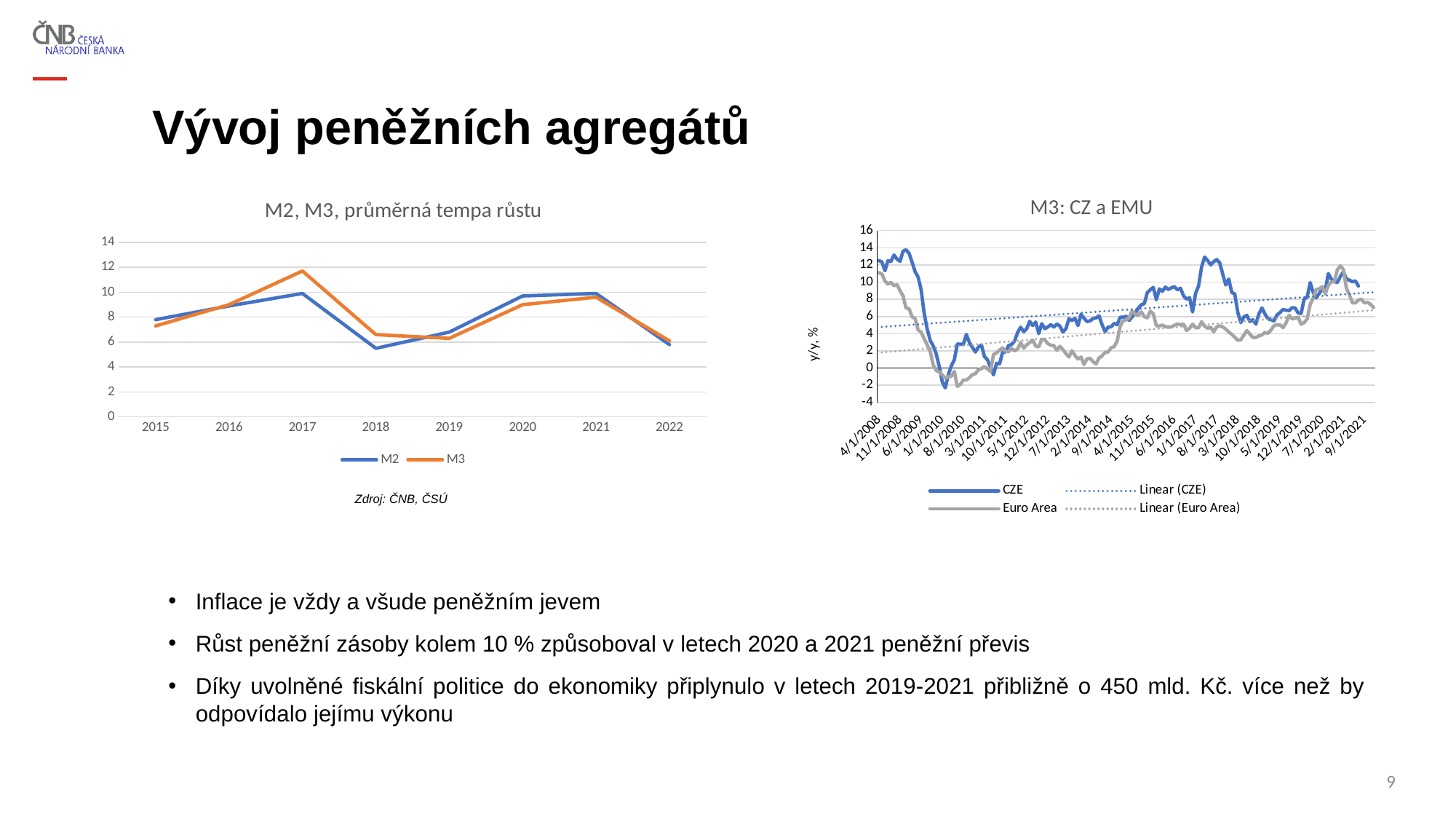
What kind of chart is the right chart titled "M3: CZ a EMU"? line chart In the left chart "M2, M3, průměrná tempa růstu", in which year is the M3 value highest? 2017 In the left chart "M2, M3, průměrná tempa růstu", how many years are shown on the x axis? 8 In the left chart "M2, M3, průměrná tempa růstu", in which year is the M2 value lowest? 2018 In the left chart "M2, M3, průměrná tempa růstu", how many series does the legend list? 2 In the right chart "M3: CZ a EMU", what is the label on the y axis? y/y, % In the left chart "M2, M3, průměrná tempa růstu", is the M3 value for 2017 greater or less than 10? greater In the left chart "M2, M3, průměrná tempa růstu", which series has the larger value in 2017, M2 or M3? M3 In the left chart "M2, M3, průměrná tempa růstu", is the M2 value for 2018 greater or less than 6? less In the left chart "M2, M3, průměrná tempa růstu", do the M2 and M3 values rise or fall from 2021 to 2022? fall In the right chart "M3: CZ a EMU", how many entries does the legend list? 4 What kind of chart is the left chart titled "M2, M3, průměrná tempa růstu"? line chart